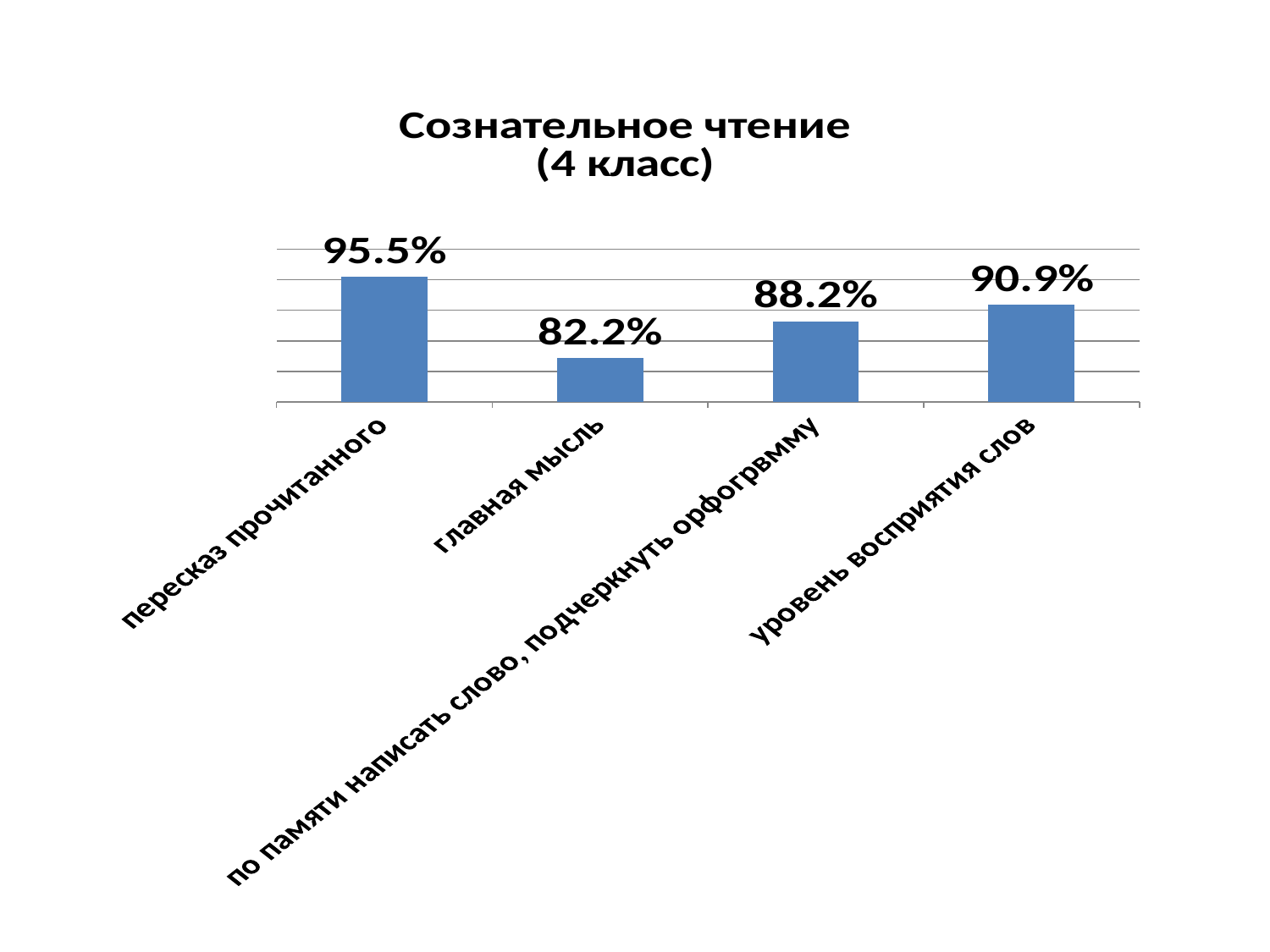
Which category has the highest value? пересказ прочитанного What is the value for главная мысль? 82.2% What is the title of the chart? Сознательное чтение (4 класс) What kind of chart is shown on the slide? bar chart What is the value for пересказ прочитанного? 95.5% What is the difference between the values for пересказ прочитанного and главная мысль? 13.3% What is the value for по памяти написать слово, подчеркнуть орфогрвмму? 88.2% What is the value for уровень восприятия слов? 90.9% How many categories are shown in the chart? 4 Which is larger: the value for уровень восприятия слов or the value for по памяти написать слово, подчеркнуть орфогрвмму? уровень восприятия слов What is the difference between the values for уровень восприятия слов and по памяти написать слово, подчеркнуть орфогрвмму? 2.7% Which category has the lowest value? главная мысль